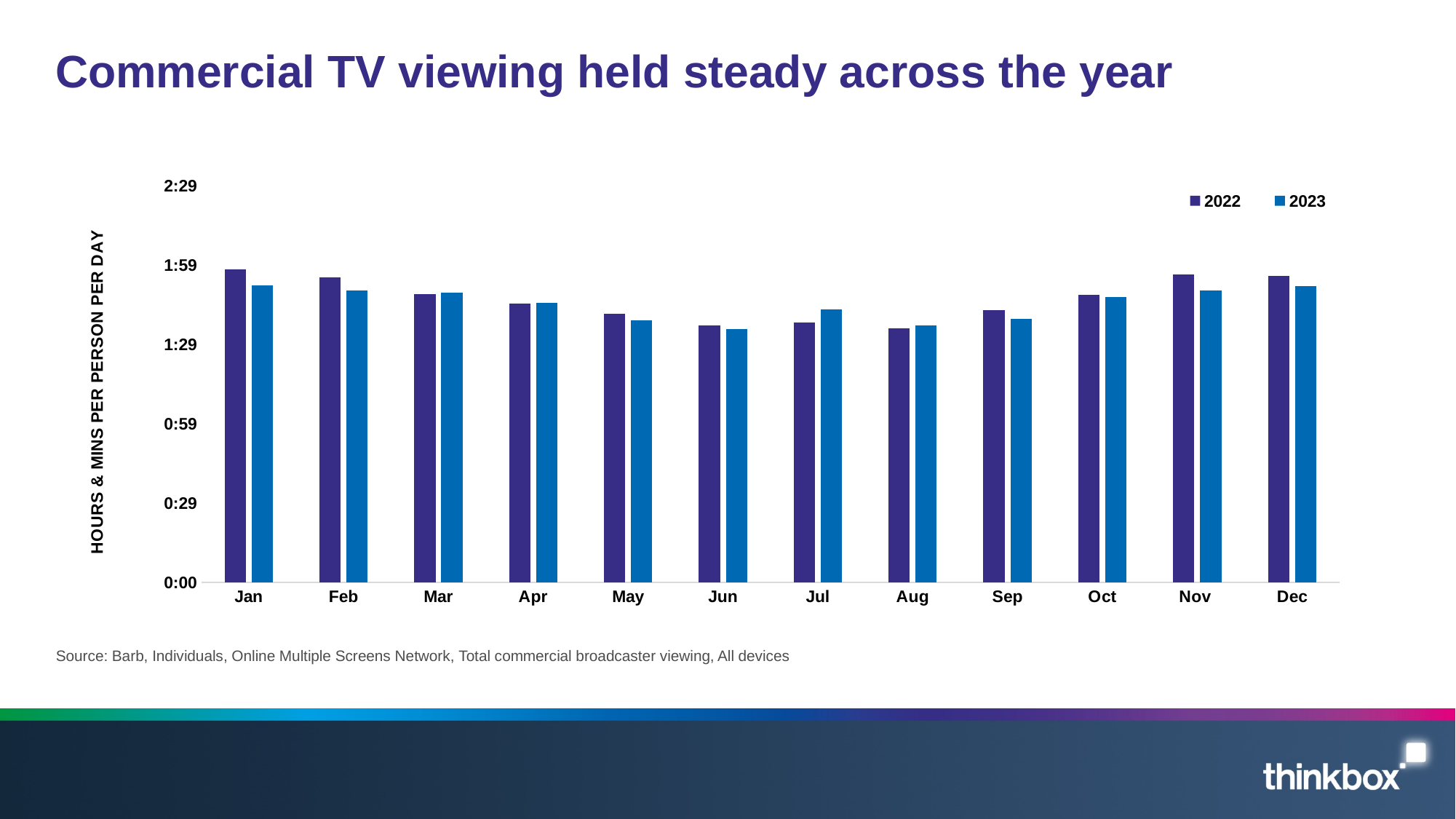
How many series does the legend list? 2 What is the label on the y axis? HOURS & MINS PER PERSON PER DAY Is the 2023 value for Jun greater or less than 1:59? less Which month has the highest value for 2022? Jan For Jul, which is larger: the 2022 value or the 2023 value? 2023 How many months are shown on the x axis? 12 What is the title of the slide? Commercial TV viewing held steady across the year Do the 2022 values rise or fall from Jan to Jun? fall For Jan, which is larger: the 2022 value or the 2023 value? 2022 Is the 2022 value for Jan greater or less than 1:29? greater What kind of chart is shown on the slide? bar chart For Nov, which is larger: the 2022 value or the 2023 value? 2022